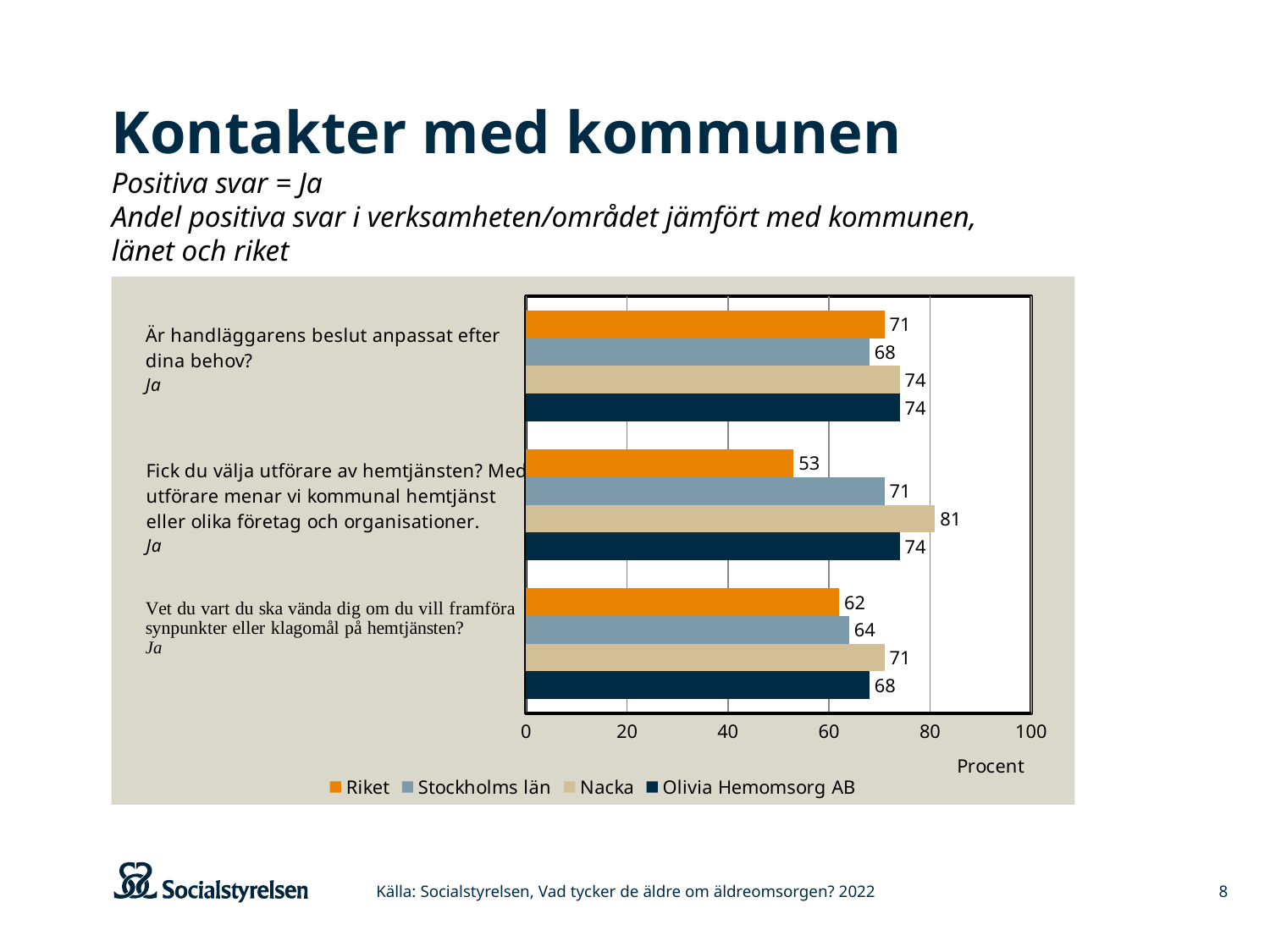
Is the value for Nacka on the question "Fick du välja utförare av hemtjänsten?" greater or less than 80? greater What is the label on the horizontal axis of the chart? Procent Which is larger on the question "Är handläggarens beslut anpassat efter dina behov?": Riket or Stockholms län? Riket What is the difference between Nacka and Riket on the question "Fick du välja utförare av hemtjänsten?"? 28 What is the value for Olivia Hemomsorg AB on the question "Vet du vart du ska vända dig om du vill framföra synpunkter eller klagomål på hemtjänsten?"? 68 Which series has the highest value on the question "Fick du välja utförare av hemtjänsten?"? Nacka How many questions (categories) are shown in the chart? 3 What is the value for Riket on the question "Fick du välja utförare av hemtjänsten?"? 53 What kind of chart is shown on the slide? Bar chart How many series does the legend list? 4 Which series has the lowest value on the question "Vet du vart du ska vända dig om du vill framföra synpunkter eller klagomål på hemtjänsten?"? Riket What is the value for Nacka on the question "Är handläggarens beslut anpassat efter dina behov?"? 74